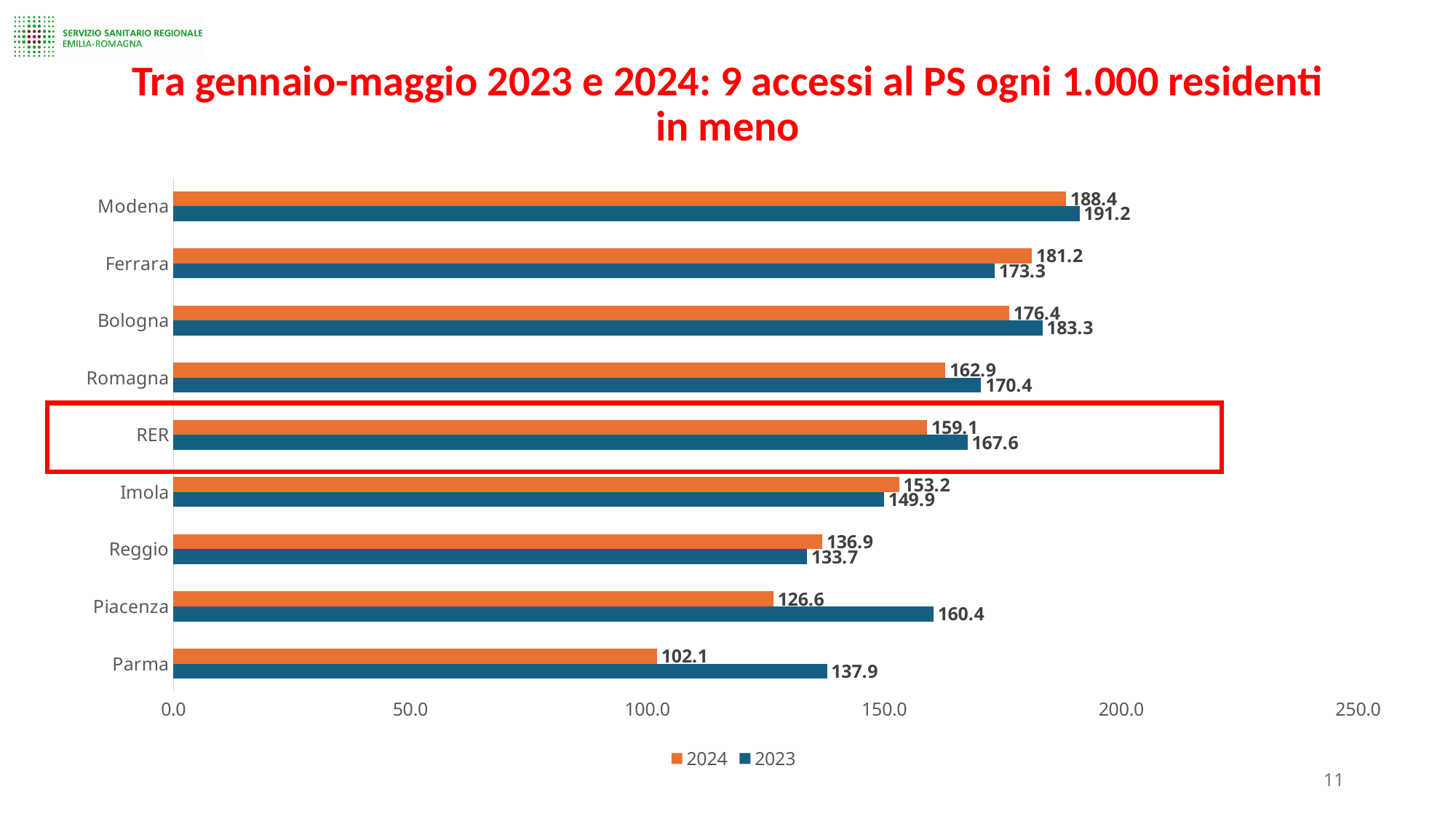
What is the 2024 value for Modena? 188.4 What is the 2024 value for RER? 159.1 Is the 2024 value for Bologna greater or less than 150.0? greater How many series does the legend list? 2 What kind of chart is shown on the slide? bar chart What is the 2023 value for Parma? 137.9 What is the difference between the 2023 and 2024 values for Piacenza? 33.8 Which category has the highest 2023 value? Modena Which category has the lowest 2024 value? Parma How many categories are shown on the chart? 9 Which category is highlighted with a red box on the chart? RER Which is larger for Ferrara, the 2024 value or the 2023 value? 2024